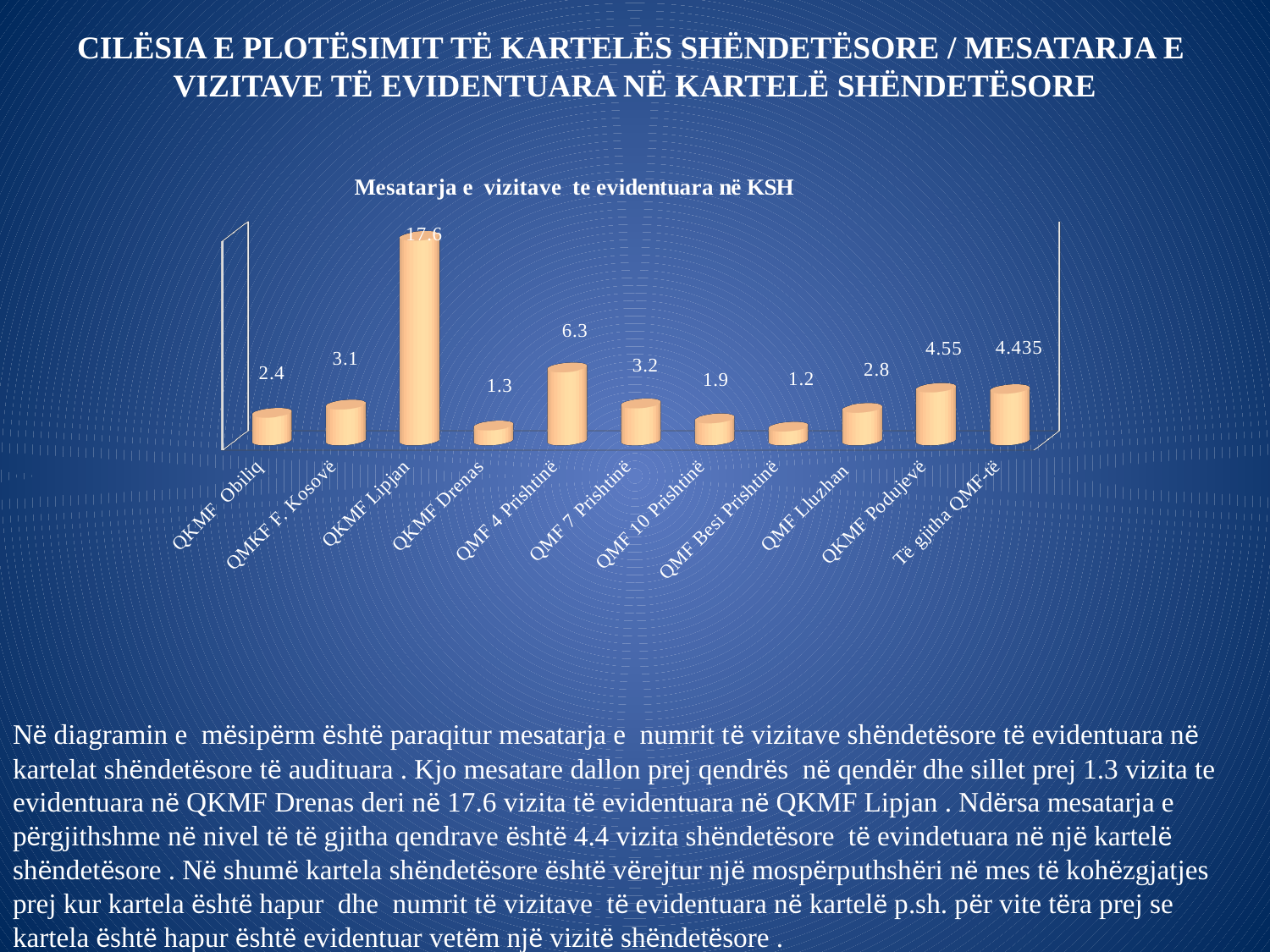
What is the value for QKMF Drenas? 1.3 What is the difference between the values for QKMF Lipjan and QKMF Drenas? 16.3 Which is larger, the value for QMF 4 Prishtinë or the value for QMF 7 Prishtinë? QMF 4 Prishtinë What is the difference between the values for QKMF Podujevë and QMF Lluzhan? 1.75 What is the value for QKMF Lipjan? 17.6 Which category has the highest value? QKMF Lipjan What is the value for QKMF Podujevë? 4.55 What kind of chart is shown on the slide? Bar chart How many categories are shown in the chart? 11 What is the title of the chart? Mesatarja e vizitave te evidentuara në KSH What is the value for Të gjitha QMF-të? 4.435 Which category has the lowest value? QMF Besi Prishtinë